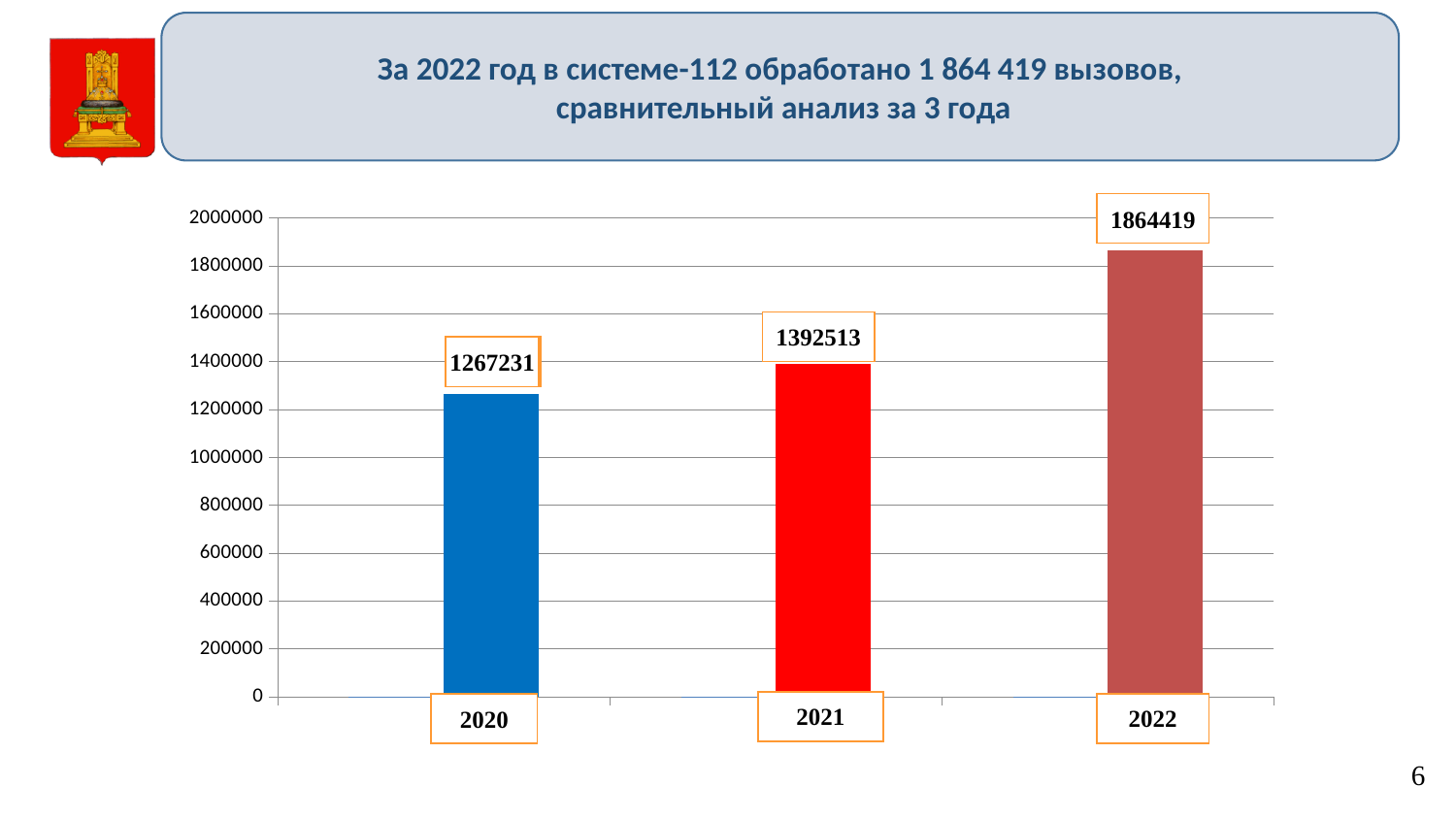
How many years are shown on the chart? 3 What is the difference between the values for 2022 and 2020? 597188 What kind of chart is shown on the slide? bar chart What is the value shown for 2021? 1392513 Which year has the lowest value? 2020 What is the difference between the values for 2022 and 2021? 471906 What is the value shown for 2020? 1267231 Which is larger, the value for 2021 or the value for 2020? 2021 What is the value shown for 2022? 1864419 Is the value for 2022 greater or less than 1800000? greater What is the difference between the values for 2021 and 2020? 125282 Which year has the highest value? 2022